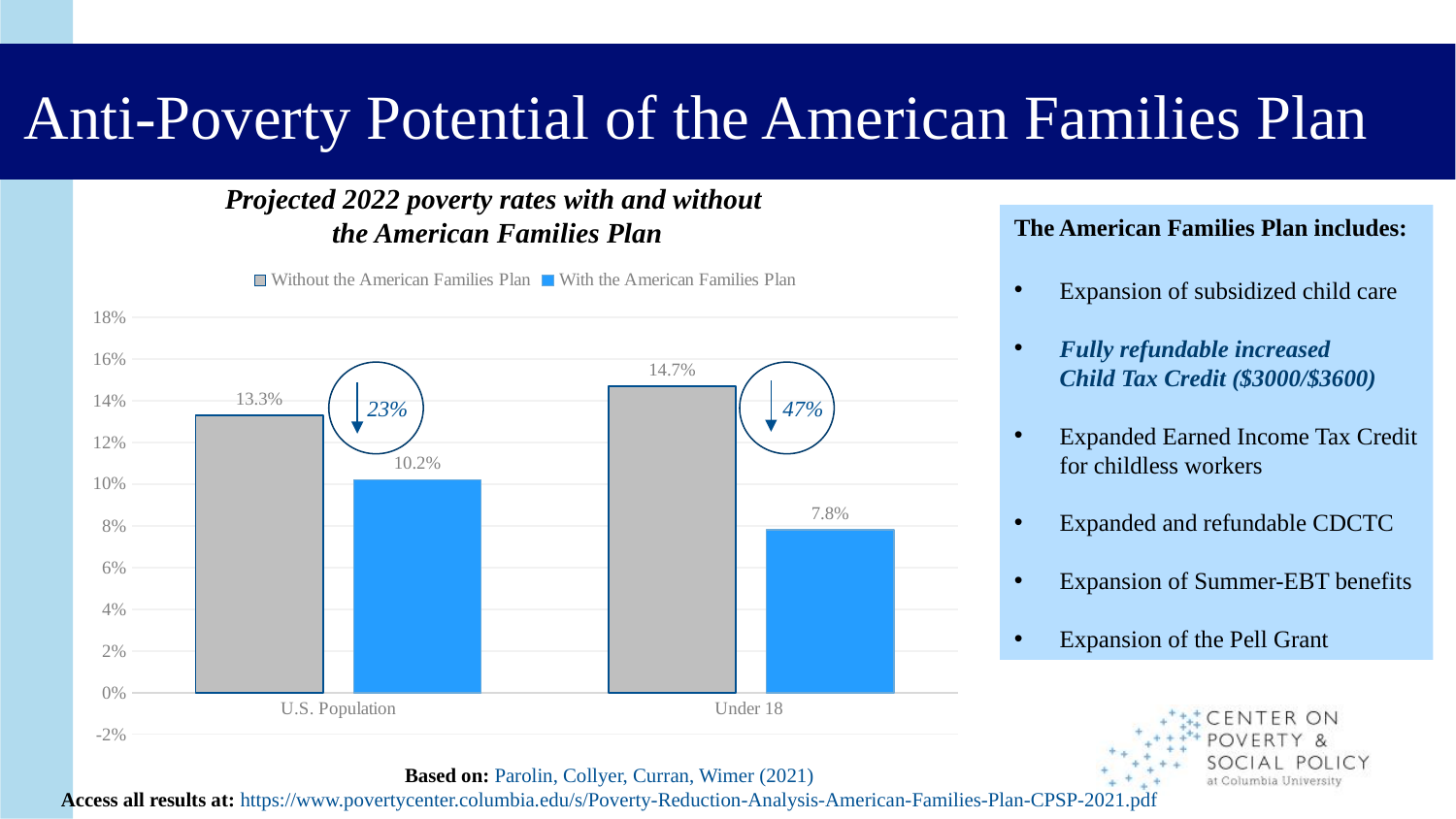
Which category has the lowest poverty rate with the American Families Plan? Under 18 How many series does the chart legend list? 2 Which is larger: the U.S. Population rate with the plan or the Under 18 rate with the plan? U.S. Population rate with the plan What percentage reduction is annotated for the Under 18 group? 47% What kind of chart is shown on the slide? Bar chart What is the projected 2022 poverty rate for Under 18 with the American Families Plan? 7.8% What is the projected 2022 poverty rate for Under 18 without the American Families Plan? 14.7% What is the projected 2022 poverty rate for the U.S. Population without the American Families Plan? 13.3% Which category has the highest poverty rate without the American Families Plan? Under 18 What is the difference between the Under 18 poverty rate without and with the American Families Plan? 6.9% What is the projected 2022 poverty rate for the U.S. Population with the American Families Plan? 10.2% How many categories are shown on the x axis of the chart? 2